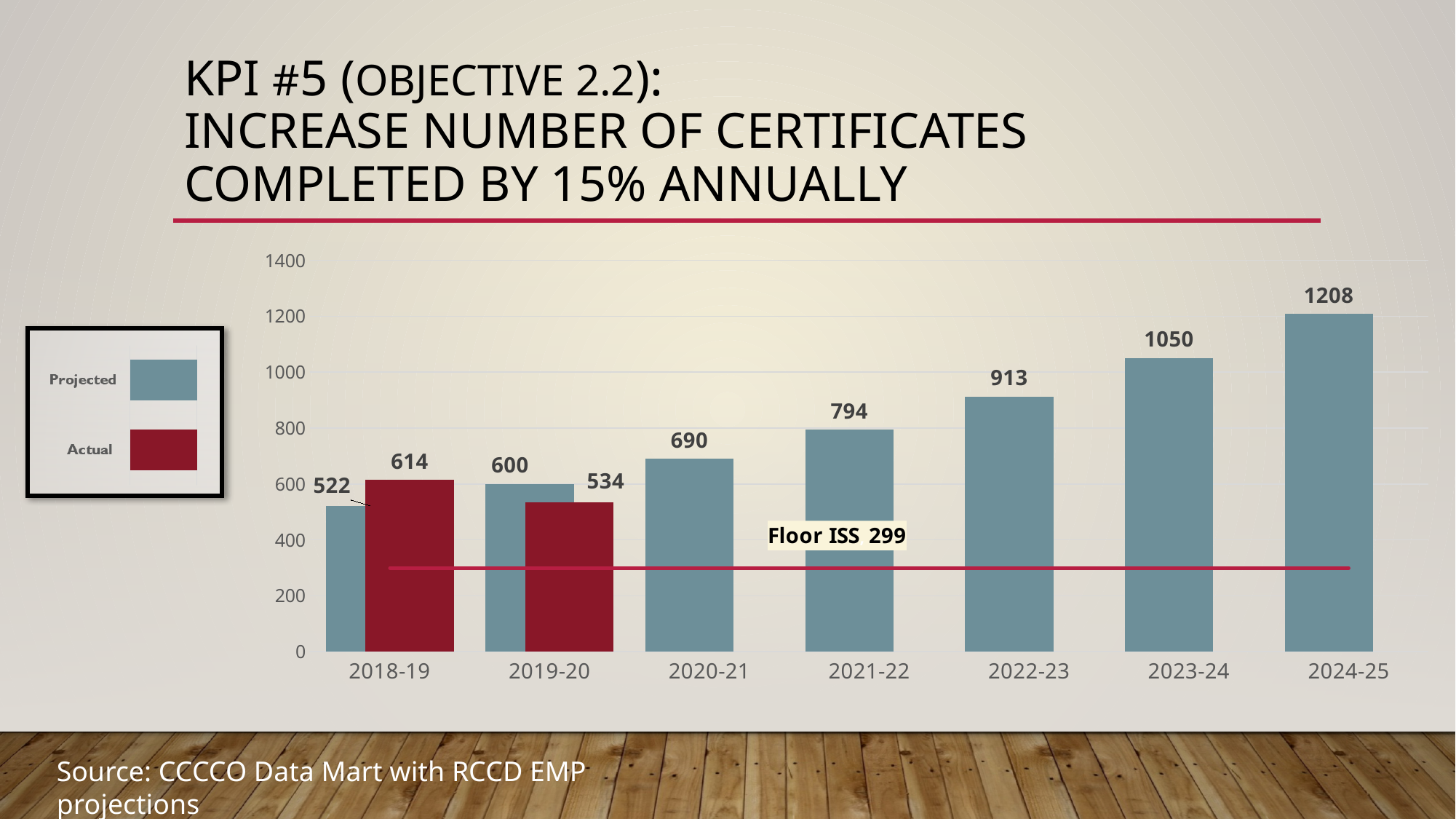
What is the difference between the actual and projected values for 2018-19? 92 How many years are shown on the x axis? 7 Which is larger for 2019-20, the projected value or the actual value? Projected What is the projected number of certificates for 2024-25? 1208 What is the actual number of certificates for 2018-19? 614 Which year has the highest projected value? 2024-25 What is the projected value for 2021-22? 794 What kind of chart is shown on the slide? Combination bar and line chart What is the actual value for 2019-20? 534 How many series does the legend list? 2 Which year has the lowest projected value? 2018-19 What value is labelled for the Floor ISS line? 299